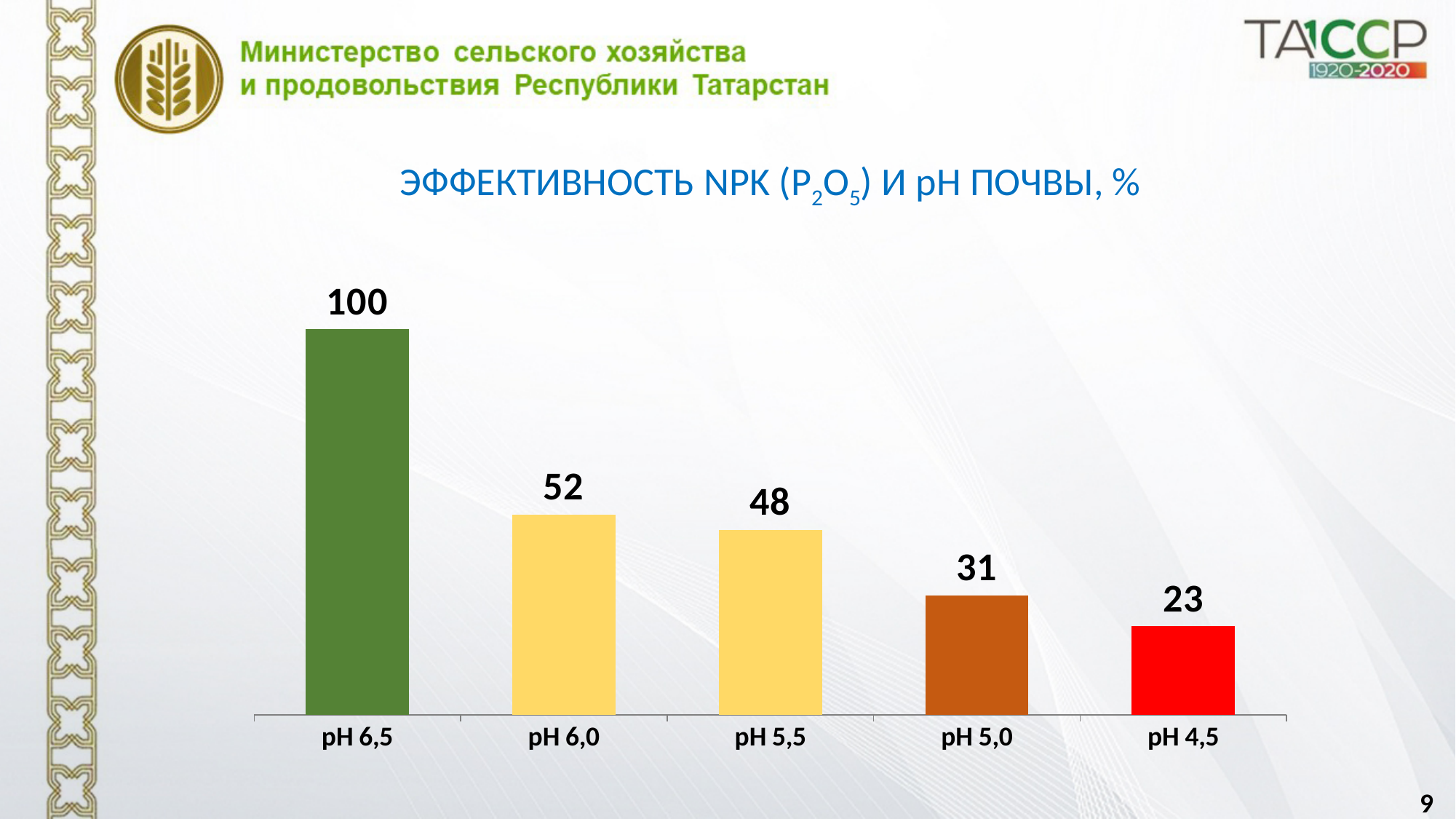
What is the difference between the values for pH 6,5 and pH 4,5? 77 What is the value for pH 6,5? 100 Which category has the highest value? pH 6,5 How many categories are shown on the chart? 5 Which category has the lowest value? pH 4,5 What kind of chart is shown on the slide? bar chart What is the value for pH 4,5? 23 Which is larger, the value for pH 6,0 or the value for pH 5,5? pH 6,0 What colour is the bar for pH 6,5? green What is the value for pH 5,5? 48 What is the difference between the values for pH 6,0 and pH 5,0? 21 Do the values rise or fall from left to right along the x axis? fall